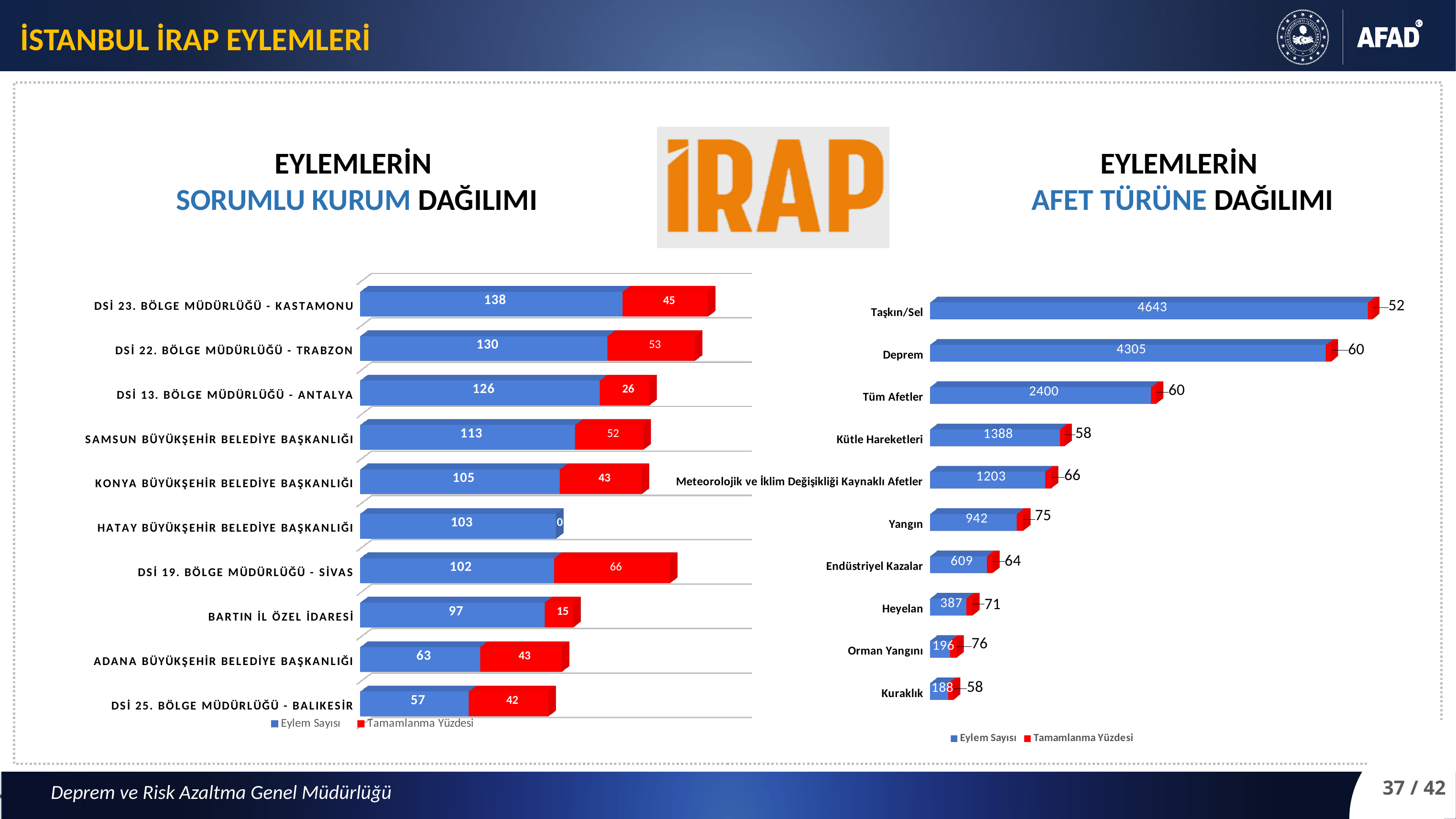
In the chart titled 'EYLEMLERİN AFET TÜRÜNE DAĞILIMI', how many series does the legend list? 2 In the chart titled 'EYLEMLERİN AFET TÜRÜNE DAĞILIMI', which has a larger Tamamlanma Yüzdesi, Yangın or Kuraklık? Yangın What type of chart is the one titled 'EYLEMLERİN AFET TÜRÜNE DAĞILIMI'? Bar chart In the chart titled 'EYLEMLERİN SORUMLU KURUM DAĞILIMI', what is the Tamamlanma Yüzdesi value for DSİ 19. BÖLGE MÜDÜRLÜĞÜ - SİVAS? 66 In the chart titled 'EYLEMLERİN AFET TÜRÜNE DAĞILIMI', what is the Eylem Sayısı value for Deprem? 4305 In the chart titled 'EYLEMLERİN AFET TÜRÜNE DAĞILIMI', which disaster type has the highest Eylem Sayısı? Taşkın/Sel In the chart titled 'EYLEMLERİN SORUMLU KURUM DAĞILIMI', what is the Eylem Sayısı value for DSİ 23. BÖLGE MÜDÜRLÜĞÜ - KASTAMONU? 138 In the chart titled 'EYLEMLERİN SORUMLU KURUM DAĞILIMI', which institution has the lowest Eylem Sayısı? DSİ 25. BÖLGE MÜDÜRLÜĞÜ - BALIKESİR In the chart titled 'EYLEMLERİN SORUMLU KURUM DAĞILIMI', what is the Tamamlanma Yüzdesi value for HATAY BÜYÜKŞEHİR BELEDİYE BAŞKANLIĞI? 0 In the chart titled 'EYLEMLERİN SORUMLU KURUM DAĞILIMI', what is the difference in Eylem Sayısı between DSİ 22. BÖLGE MÜDÜRLÜĞÜ - TRABZON and ADANA BÜYÜKŞEHİR BELEDİYE BAŞKANLIĞI? 67 In the chart titled 'EYLEMLERİN SORUMLU KURUM DAĞILIMI', how many institutions are listed? 10 In the chart titled 'EYLEMLERİN AFET TÜRÜNE DAĞILIMI', what is the difference in Eylem Sayısı between Taşkın/Sel and Deprem? 338